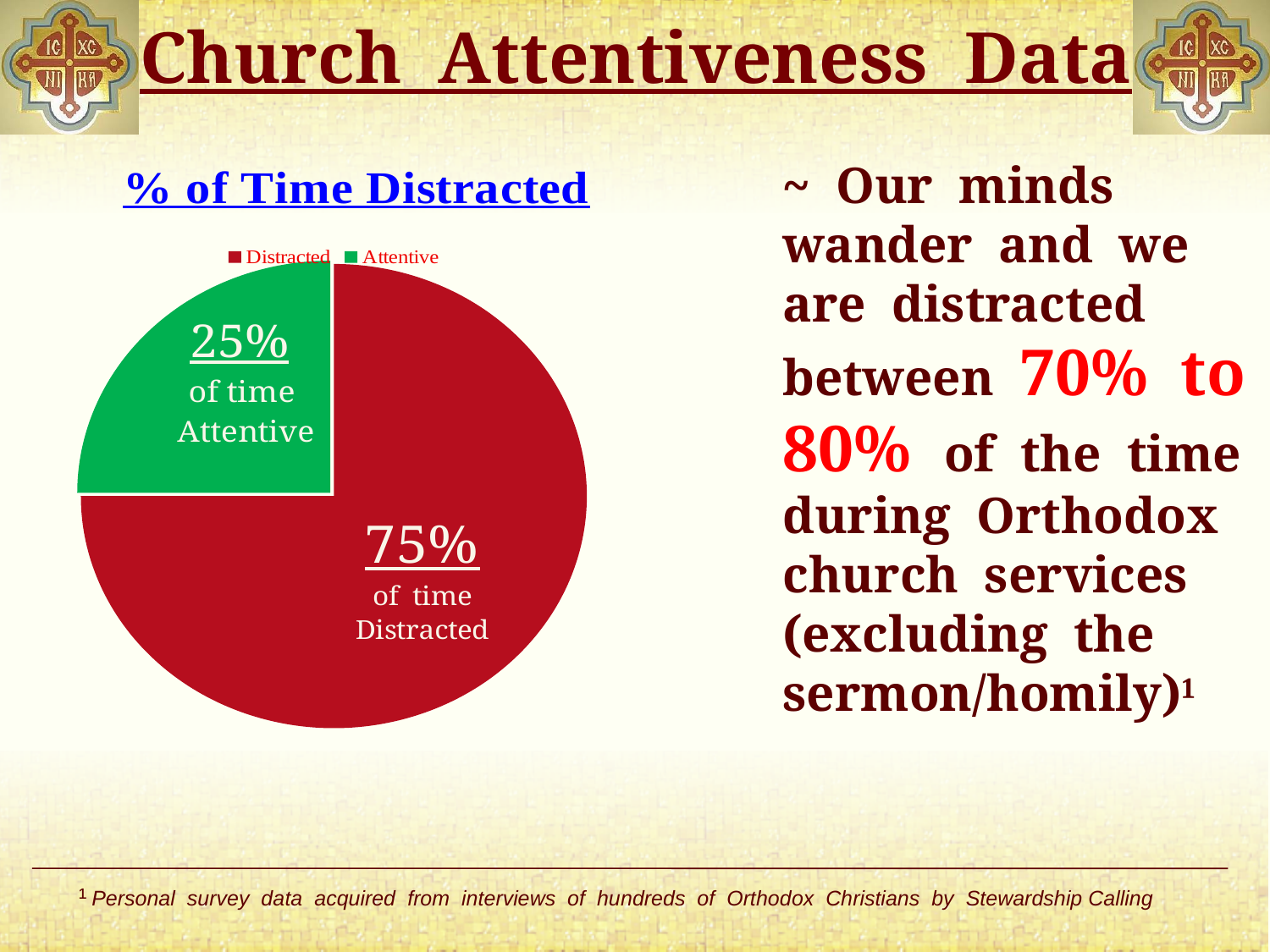
Which is larger, the Distracted slice or the Attentive slice? Distracted Which slice of the pie chart is the smallest? Attentive Which slice of the pie chart is the largest? Distracted What percentage of time is labelled as Attentive in the pie chart? 25% What is the title of the chart? % of Time Distracted What percentage of time is labelled as Distracted in the pie chart? 75% What colour is the Attentive slice in the pie chart? Green What is the difference between the Distracted and Attentive percentages? 50% How many slices does the pie chart have? 2 What kind of chart is shown on the slide? Pie chart What share of the pie does the Distracted slice represent? 75% How many entries does the chart legend list? 2